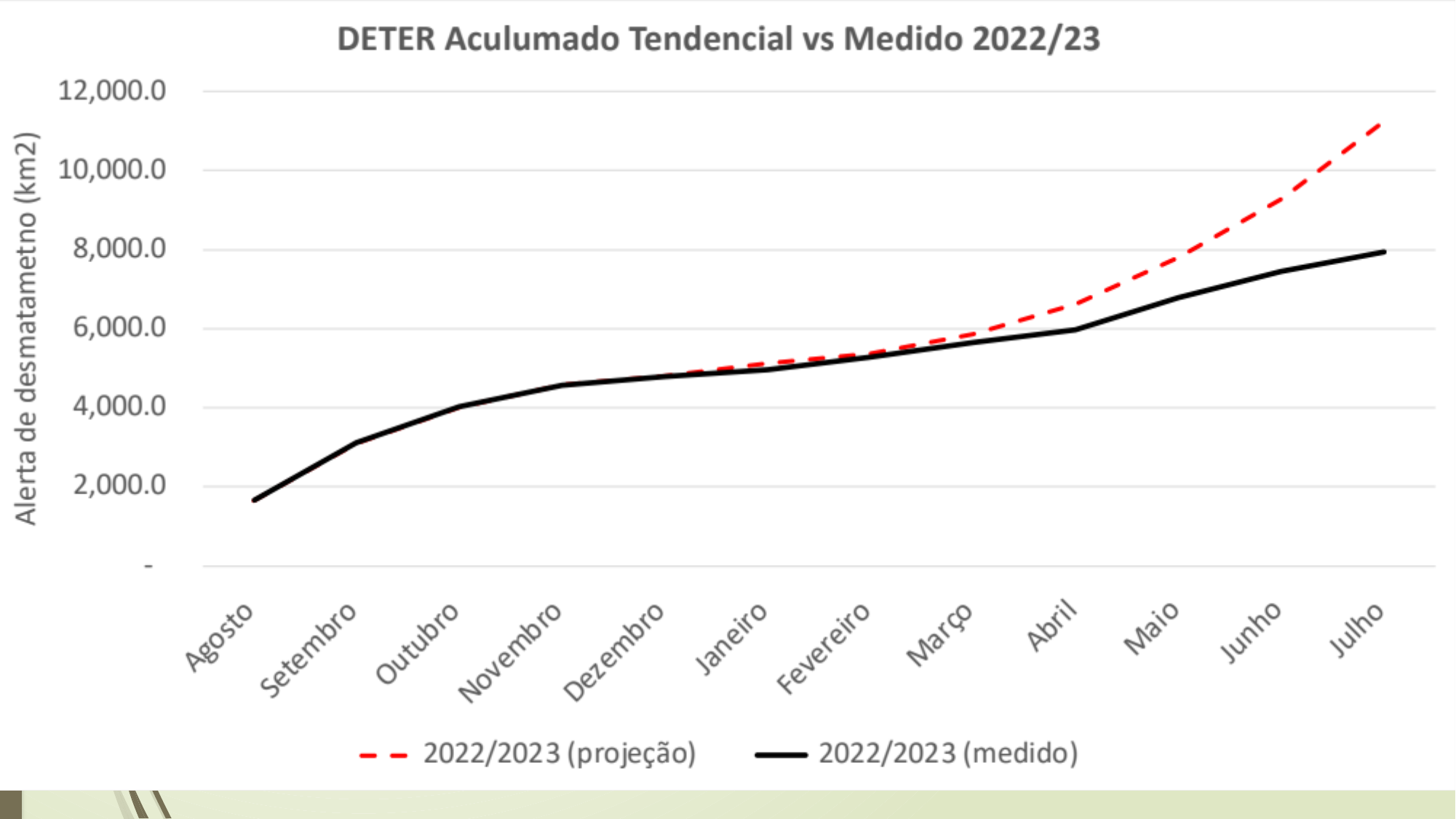
What kind of chart is shown on the slide? line chart Is the 2022/2023 (medido) value for Agosto greater or less than 2,000.0? less Which series is drawn as a red dashed line? 2022/2023 (projeção) How many months are shown along the x axis? 12 Does the 2022/2023 (medido) line rise or fall from Agosto to Julho? rise In which month does the 2022/2023 (medido) series reach its highest value? Julho Is the 2022/2023 (projeção) value for Julho greater or less than 10,000.0? greater How many series does the legend list? 2 In Julho, which series has the larger value, 2022/2023 (projeção) or 2022/2023 (medido)? 2022/2023 (projeção) In which month is the 2022/2023 (medido) series at its lowest value? Agosto Is the 2022/2023 (projeção) value for Junho greater or less than 8,000.0? greater What is the title of the chart? DETER Aculumado Tendencial vs Medido 2022/23